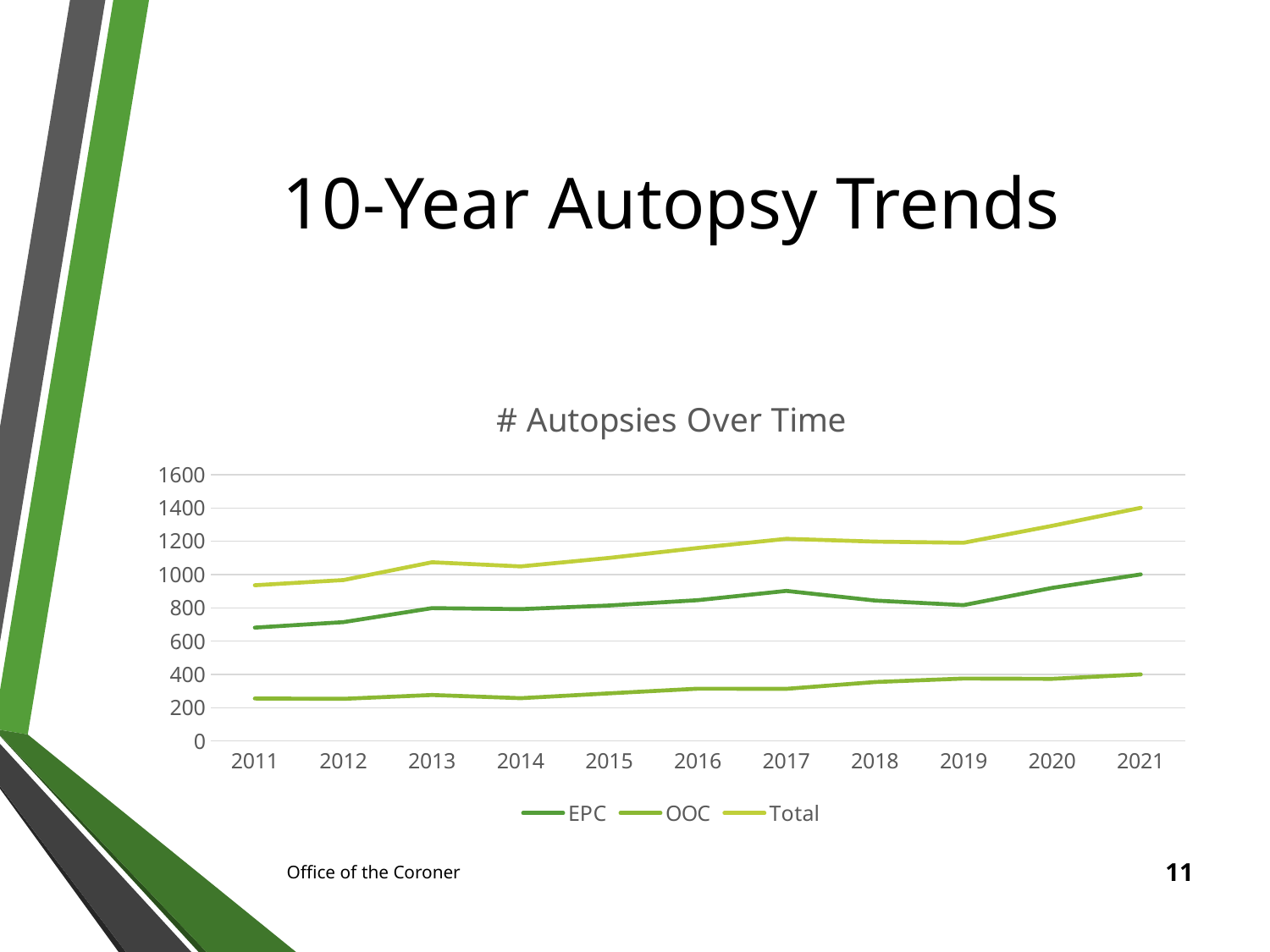
Is the Total value for 2021 greater or less than 1200? greater Which series has the highest values across all years? Total Is the EPC value for 2011 greater or less than 800? less Which is larger, the EPC value in 2017 or the EPC value in 2019? 2017 What kind of chart is shown on the slide? line chart Does the Total series generally rise or fall from 2011 to 2021? rise How many series does the legend list? 3 How many years are shown on the x axis? 11 Is the OOC value for 2014 greater or less than 400? less Which series has the lowest values across all years? OOC What is the title of the chart? # Autopsies Over Time